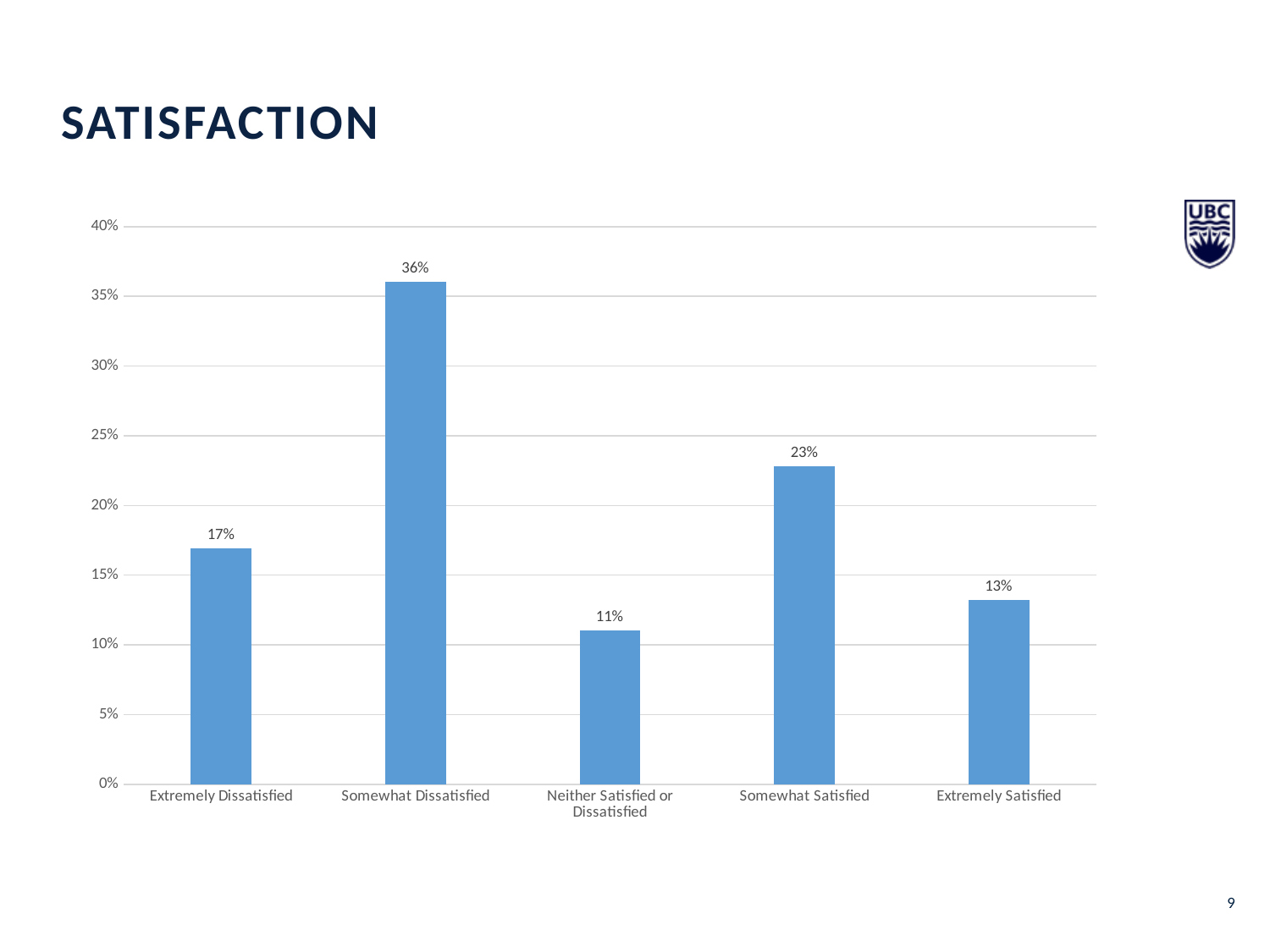
Is the value for Somewhat Satisfied greater or less than 20%? greater What is the value for Neither Satisfied or Dissatisfied? 11% What is the title of the slide? SATISFACTION Which category has the lowest value? Neither Satisfied or Dissatisfied What kind of chart is shown on the slide? bar chart What is the highest value shown on the y axis? 40% Which category has the highest value? Somewhat Dissatisfied Which is larger, the value for Extremely Dissatisfied or the value for Extremely Satisfied? Extremely Dissatisfied What is the value for Extremely Satisfied? 13% What is the difference between the values for Somewhat Dissatisfied and Somewhat Satisfied? 13% What is the value for Somewhat Dissatisfied? 36% How many categories are shown on the x axis? 5